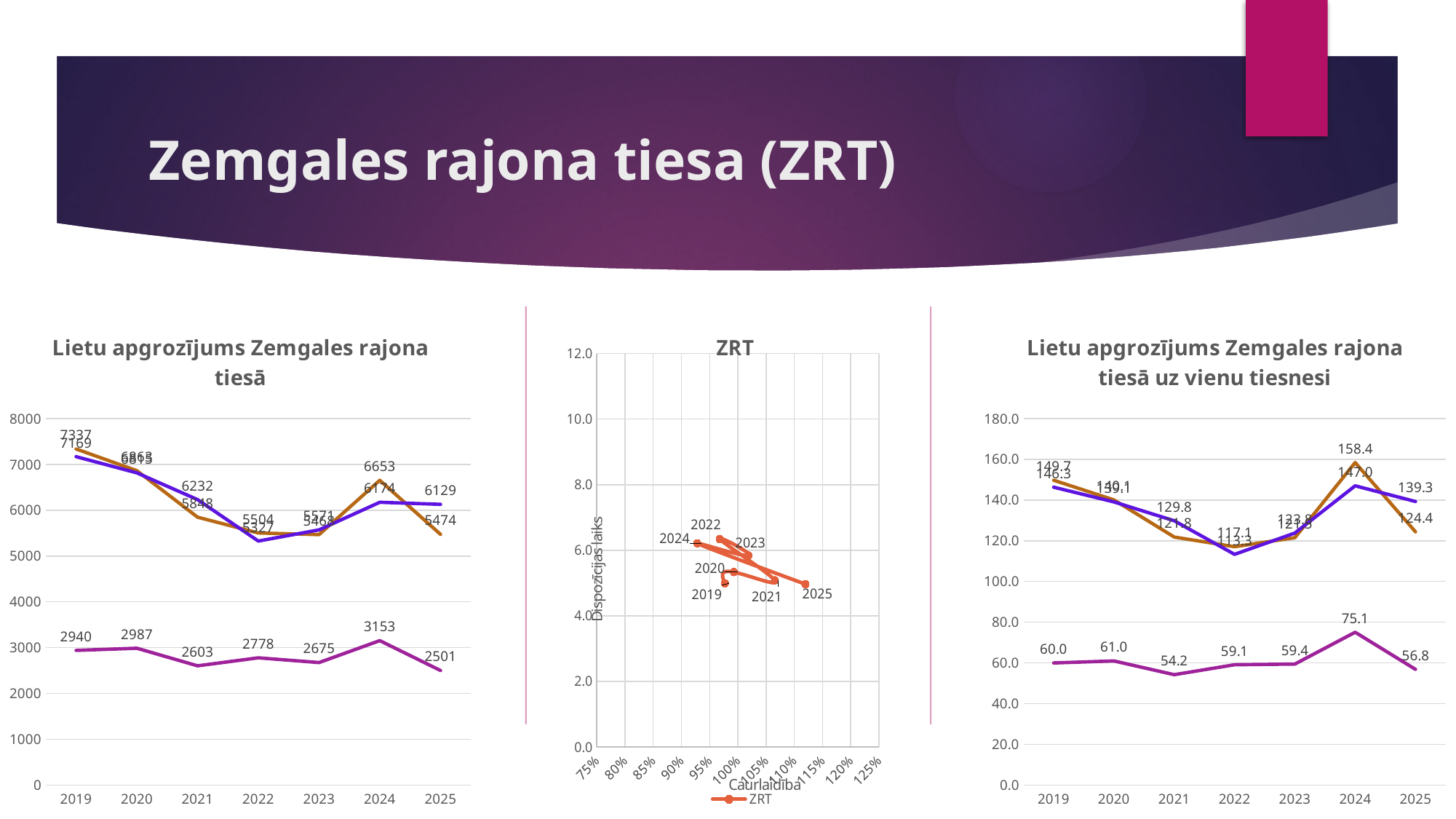
On the 'ZRT' chart, is the Dispozīcijas laiks value for 2025 greater or less than 6.0? less What is the x-axis title of the 'ZRT' chart? Caurlaidība On the chart 'Lietu apgrozījums Zemgales rajona tiesā', what is the difference between the purple line's 2024 value and its 2025 value? 652 How many series does the legend of the 'ZRT' chart list? 1 On the chart 'Lietu apgrozījums Zemgales rajona tiesā', in which year is the purple line lowest? 2025 On the chart 'Lietu apgrozījums Zemgales rajona tiesā', what is the value of the brown line in 2024? 6653 How many years are shown on the x axis of the chart 'Lietu apgrozījums Zemgales rajona tiesā'? 7 On the chart 'Lietu apgrozījums Zemgales rajona tiesā uz vienu tiesnesi', in which year is the purple line highest? 2024 On the chart 'Lietu apgrozījums Zemgales rajona tiesā', which is larger for the purple line: the 2019 value or the 2020 value? 2020 On the chart 'Lietu apgrozījums Zemgales rajona tiesā', what is the value of the purple line in 2024? 3153 On the chart 'Lietu apgrozījums Zemgales rajona tiesā uz vienu tiesnesi', what is the difference between the purple line's 2024 value and its 2021 value? 20.9 What kind of chart is the middle chart titled 'ZRT'? scatter chart